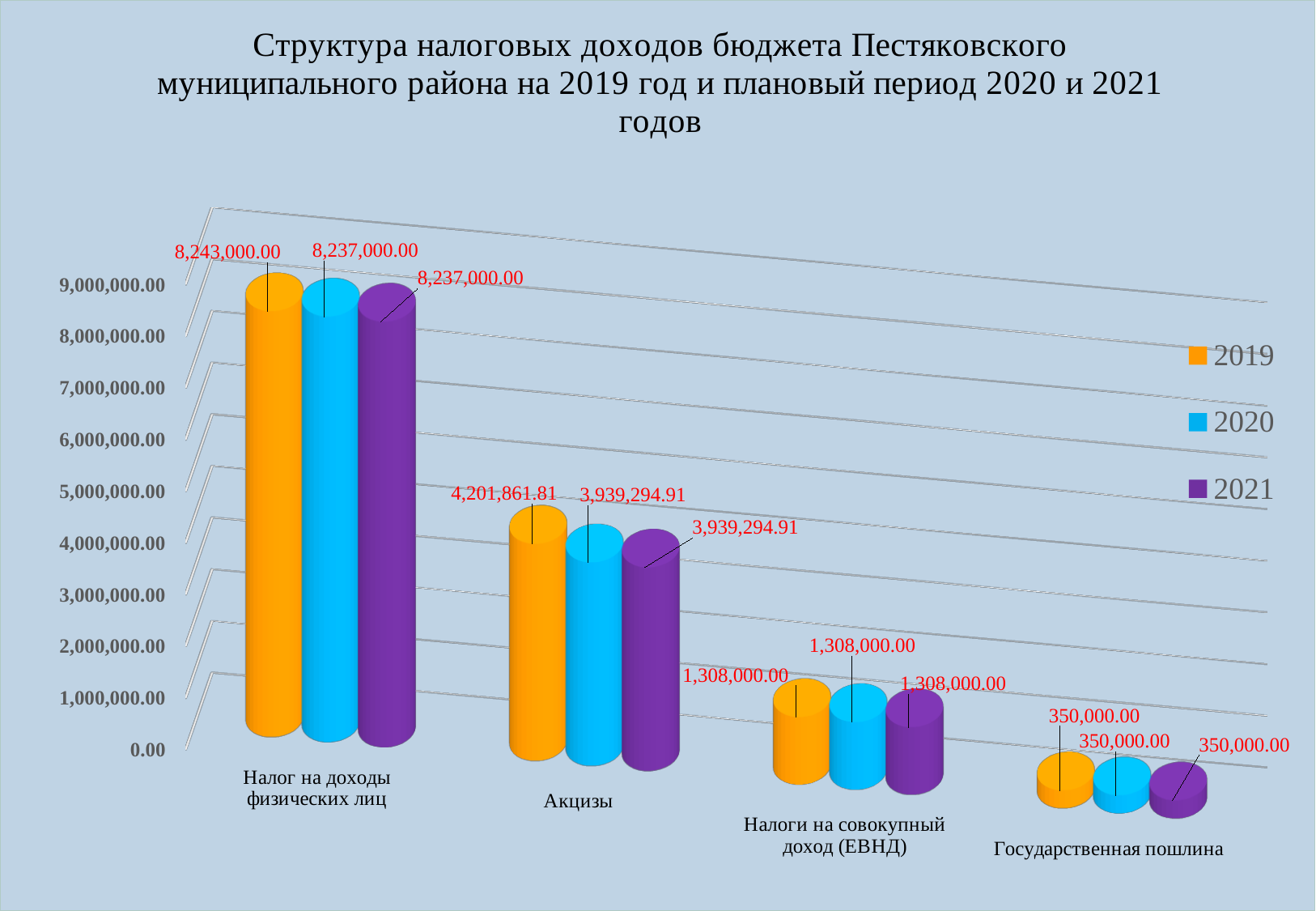
What kind of chart is shown on the slide? Bar chart What is the 2019 value for Налог на доходы физических лиц? 8,243,000.00 What is the 2019 value for Государственная пошлина? 350,000.00 Which category has the highest 2019 value? Налог на доходы физических лиц What is the difference between the 2019 and 2021 values for Акцизы? 262,566.90 What is the 2021 value for Налоги на совокупный доход (ЕВНД)? 1,308,000.00 What is the 2020 value for Акцизы? 3,939,294.91 How many categories are shown on the x axis? 4 How many series does the legend list? 3 Which category has the lowest 2021 value? Государственная пошлина Which is larger: the 2019 value for Акцизы or the 2019 value for Налоги на совокупный доход (ЕВНД)? Акцизы What is the difference between the 2019 and 2020 values for Налог на доходы физических лиц? 6,000.00